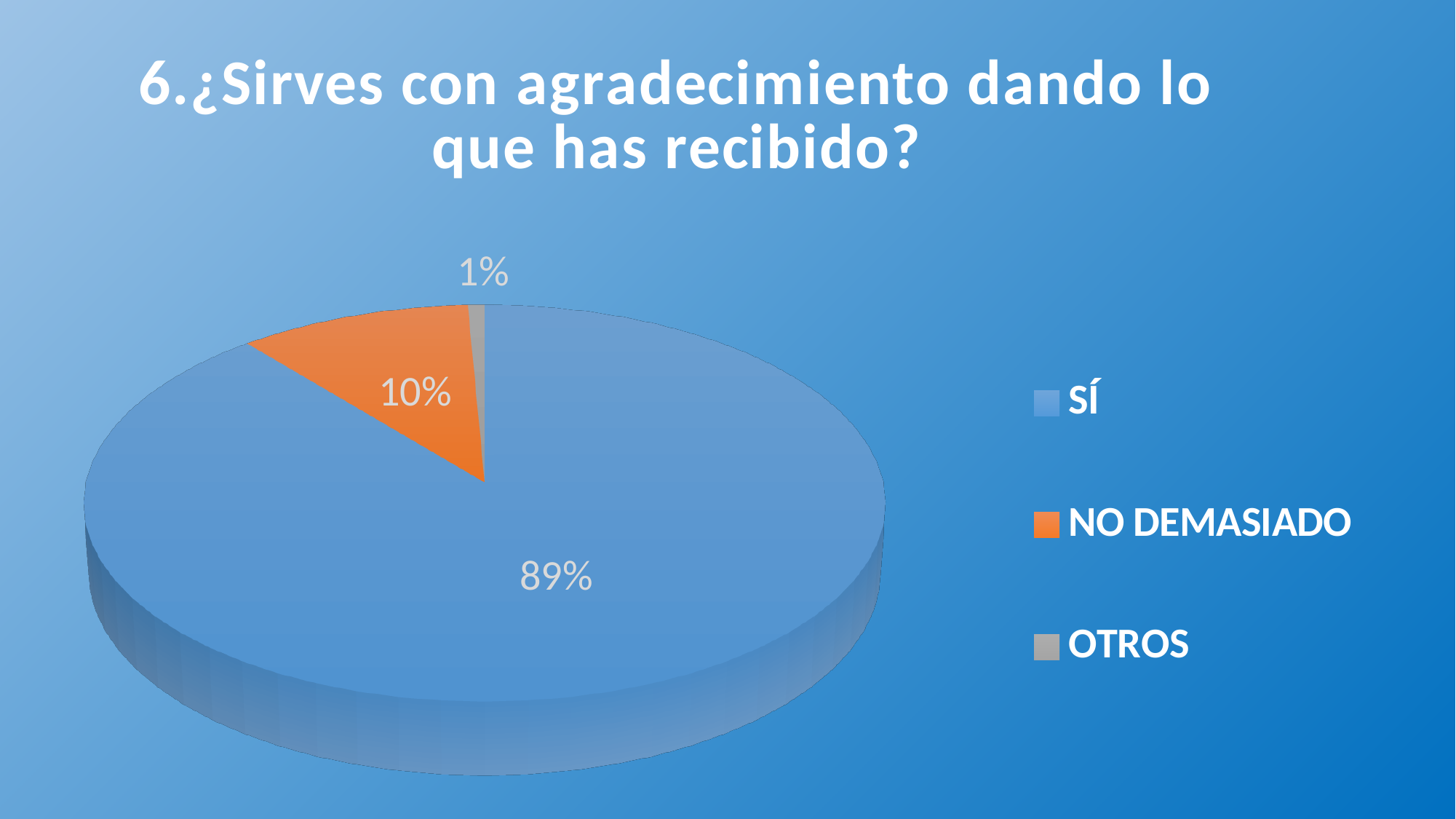
Which category has the smallest slice of the pie? OTROS What is the title of the chart? 6.¿Sirves con agradecimiento dando lo que has recibido? What kind of chart is shown on the slide? Pie chart Which is larger, the slice for NO DEMASIADO or the slice for OTROS? NO DEMASIADO What colour is the slice for NO DEMASIADO? Orange What share of the pie does SÍ represent? 89% What is the difference between the NO DEMASIADO and OTROS percentages? 9% What is the value shown for OTROS? 1% What is the value shown for NO DEMASIADO? 10% Which category has the largest slice of the pie? SÍ What is the difference between the SÍ and NO DEMASIADO percentages? 79% How many categories does the pie chart show? 3